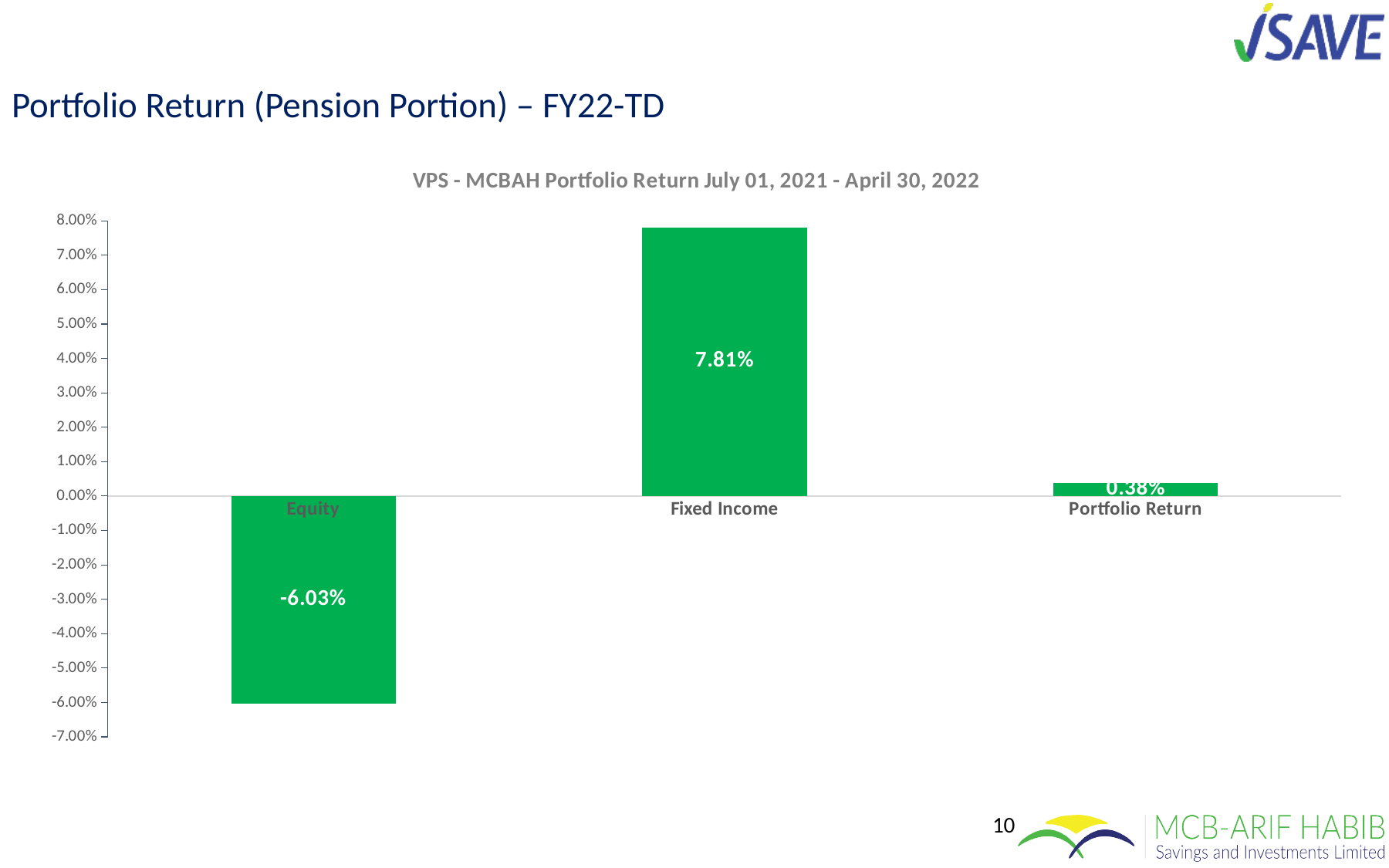
What is the value for Portfolio Return? 0.38% Which category has the highest value? Fixed Income What kind of chart is shown on the slide? Bar chart What is the difference between the Fixed Income value and the Equity value? 13.84% What is the value for Fixed Income? 7.81% How many categories are shown on the chart? 3 What is the value for Equity? -6.03% Is the value for Fixed Income greater or less than 7.00%? greater What is the title of the chart? VPS - MCBAH Portfolio Return July 01, 2021 - April 30, 2022 What is the difference between the Fixed Income value and the Portfolio Return value? 7.43% Which category has the lowest value? Equity Which is larger, the value for Fixed Income or the value for Portfolio Return? Fixed Income